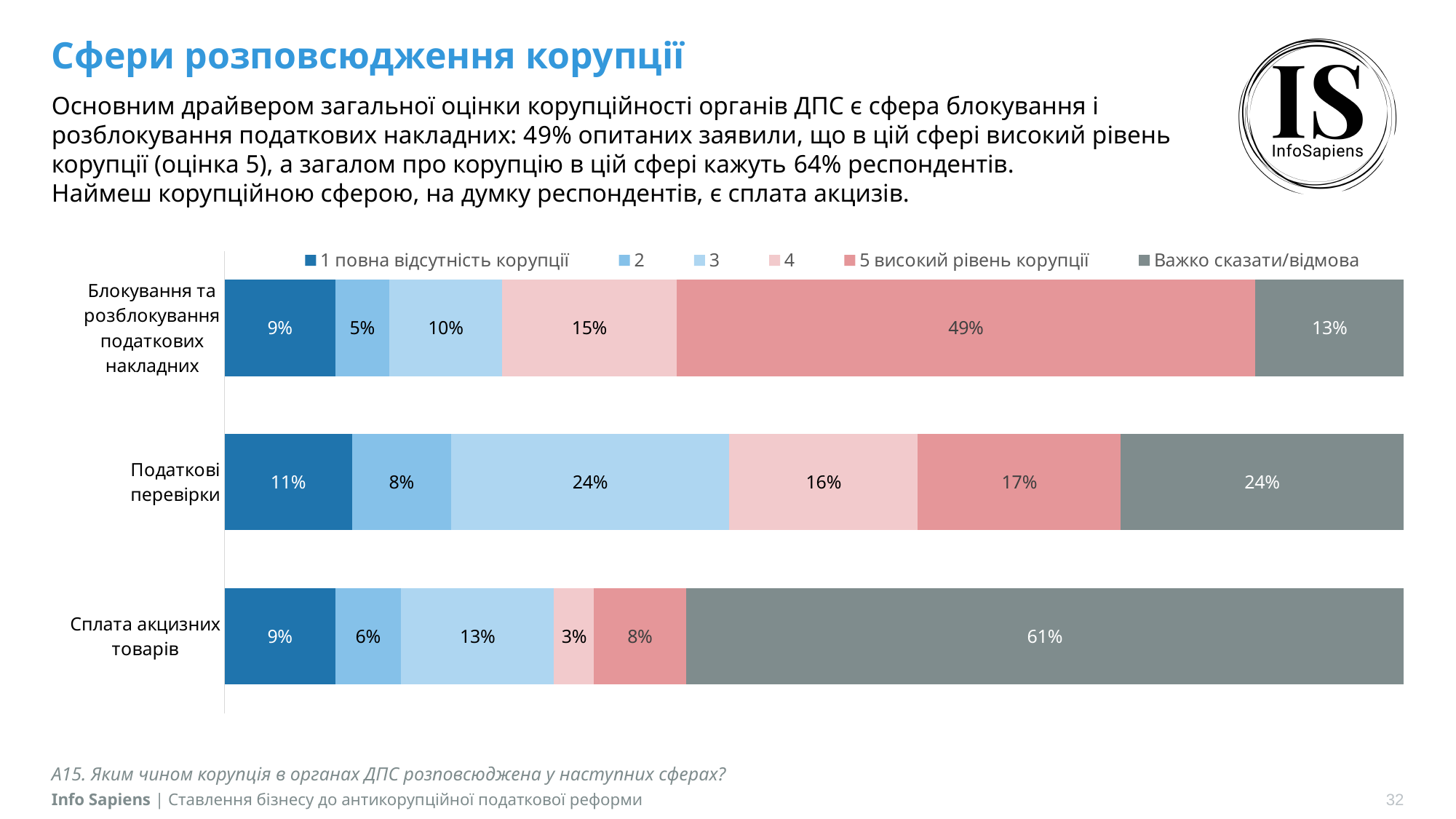
What kind of chart is shown on the slide? Stacked bar chart Which category has the highest value for 5 високий рівень корупції? Блокування та розблокування податкових накладних Which is larger: the 1 повна відсутність корупції value for Податкові перевірки or for Сплата акцизних товарів? Податкові перевірки How many series does the legend list? 6 What is the value of Важко сказати/відмова for Сплата акцизних товарів? 61% What is the value of the 4 segment for Сплата акцизних товарів? 3% Which category has the lowest value for Важко сказати/відмова? Блокування та розблокування податкових накладних What percentage of respondents gave a score of 5 (високий рівень корупції) for Блокування та розблокування податкових накладних? 49% What percentage of respondents gave a score of 3 for Податкові перевірки? 24% How many categories are shown on the chart? 3 What is the difference between the 5 високий рівень корупції values for Блокування та розблокування податкових накладних and Податкові перевірки? 32 percentage points What is the total of the stacked bar for Податкові перевірки? 100%